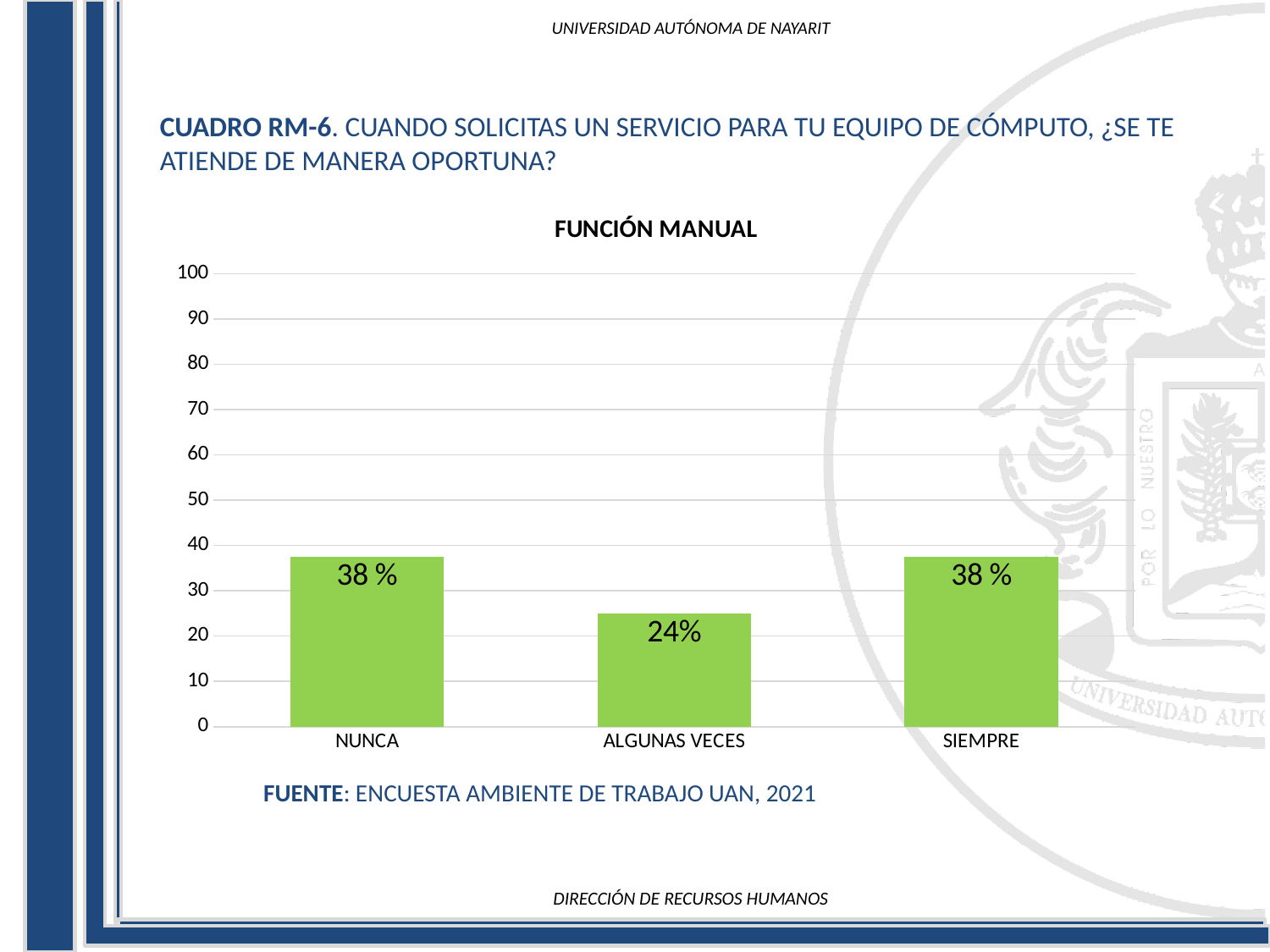
What kind of chart is shown on the slide? bar chart Which category has the lowest value? ALGUNAS VECES What is the title of the chart? FUNCIÓN MANUAL What is the value for SIEMPRE? 38 % Is the value for SIEMPRE greater or less than 40? less Is the value for NUNCA greater or less than 30? greater What is the value for NUNCA? 38 % Is the value for ALGUNAS VECES greater or less than 30? less How many categories are shown on the x axis? 3 Which is larger, the value for NUNCA or the value for ALGUNAS VECES? NUNCA What is the difference between the value for SIEMPRE and the value for ALGUNAS VECES? 14 What is the value for ALGUNAS VECES? 24%